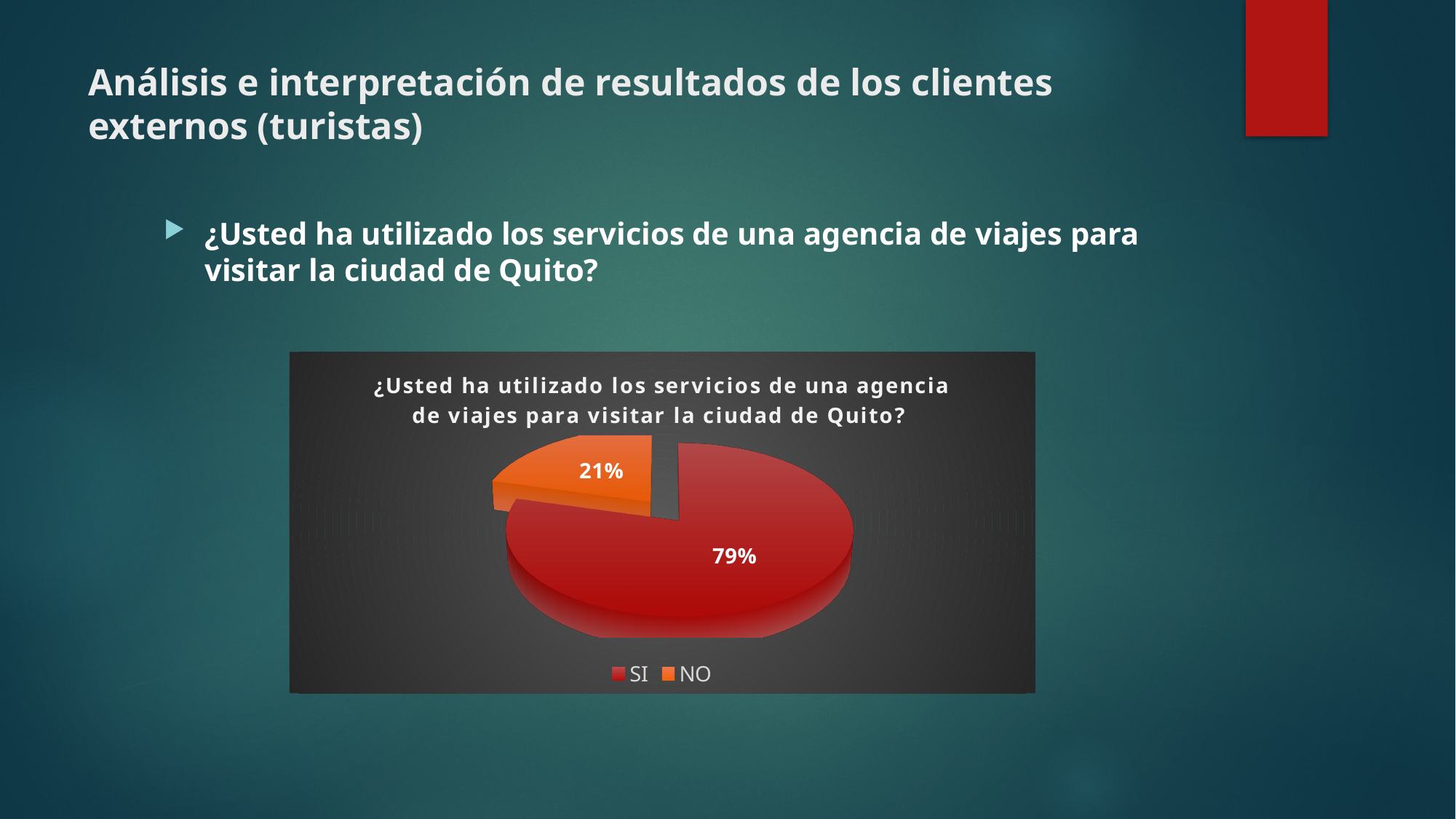
What is the difference in percentage points between the SI and NO slices? 58 What share of the pie does the SI slice represent? 79% Which slice is larger, SI or NO? SI What percentage of respondents answered SI? 79% How many entries does the legend list? 2 How many slices does the pie chart have? 2 What percentage of respondents answered NO? 21% What colour is the NO slice? Orange What kind of chart is shown on the slide? Pie chart What is the title of the chart? ¿Usted ha utilizado los servicios de una agencia de viajes para visitar la ciudad de Quito? Which response has the smallest share of the pie? NO Which response has the largest share of the pie? SI